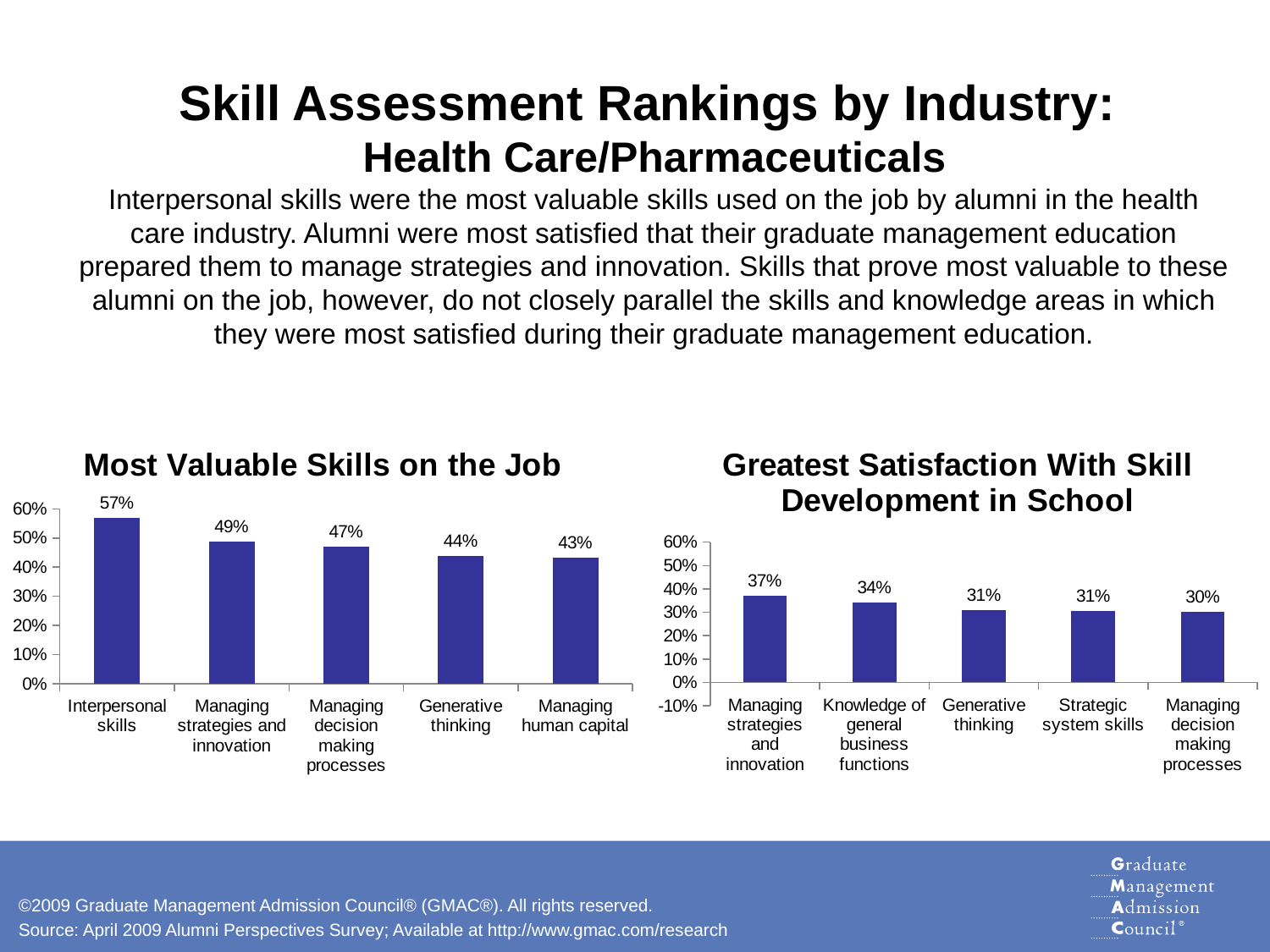
Which is larger: Managing strategies and innovation in the 'Most Valuable Skills on the Job' chart or Managing strategies and innovation in the 'Greatest Satisfaction With Skill Development in School' chart? Most Valuable Skills on the Job (49%) In the 'Most Valuable Skills on the Job' chart, is the value for Managing decision making processes greater or less than 40%? greater How many categories are shown in the 'Greatest Satisfaction With Skill Development in School' chart? 5 In the 'Most Valuable Skills on the Job' chart, which category has the lowest value? Managing human capital In the 'Greatest Satisfaction With Skill Development in School' chart, do the values rise or fall from left to right? Fall What kind of chart is the 'Most Valuable Skills on the Job' chart? Bar chart In the 'Greatest Satisfaction With Skill Development in School' chart, what is the value for Knowledge of general business functions? 34% In the 'Greatest Satisfaction With Skill Development in School' chart, which category has the highest value? Managing strategies and innovation In the 'Most Valuable Skills on the Job' chart, what is the value for Generative thinking? 44% In the 'Most Valuable Skills on the Job' chart, what is the value for Interpersonal skills? 57% In the 'Most Valuable Skills on the Job' chart, what is the difference between Interpersonal skills and Managing human capital? 14% In the 'Greatest Satisfaction With Skill Development in School' chart, what is the difference between Managing strategies and innovation and Managing decision making processes? 7%